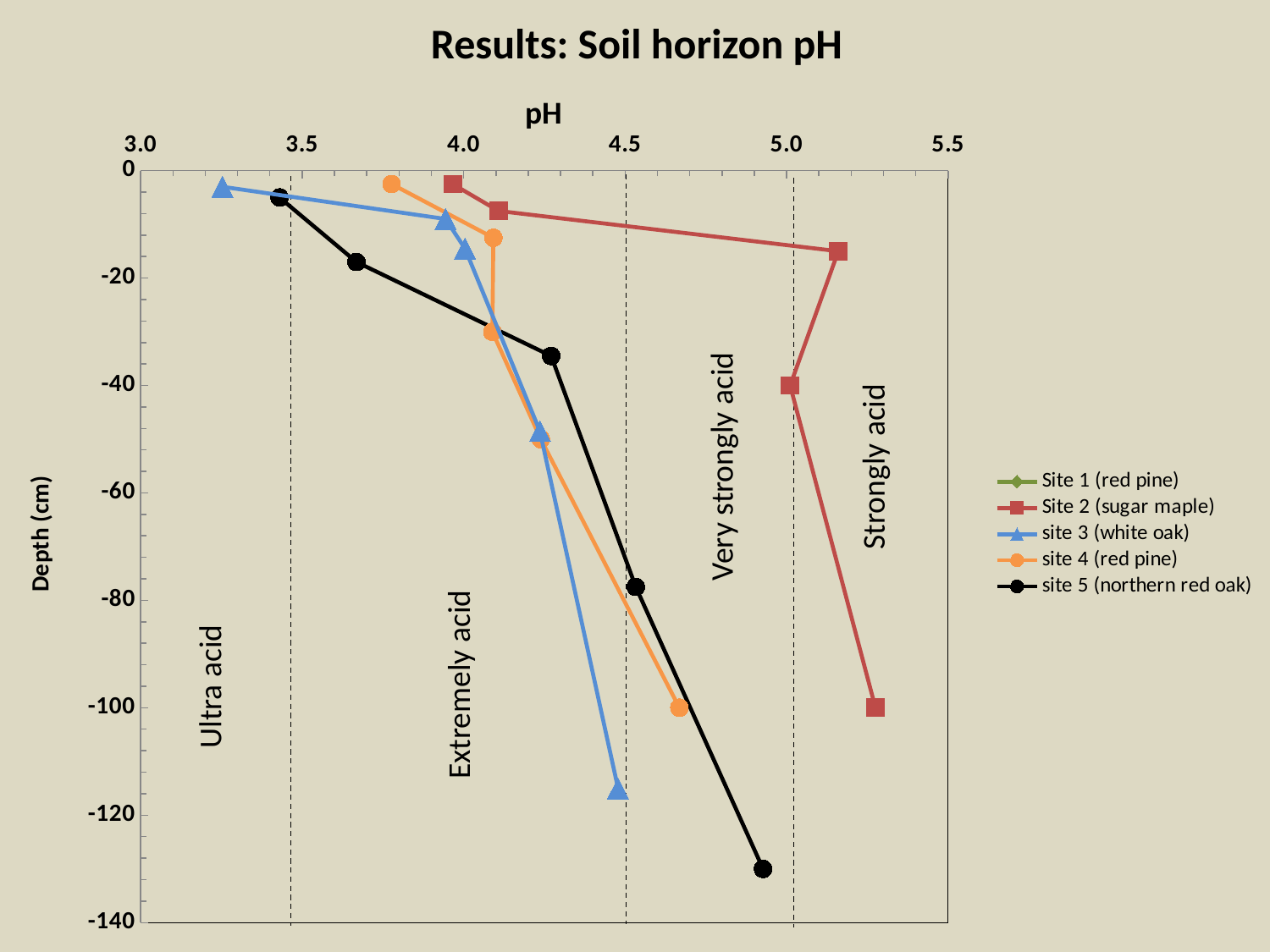
For site 5 (northern red oak), does pH increase or decrease as depth increases? increase What is the title of the chart? Results: Soil horizon pH What is the label of the vertical axis? Depth (cm) Is the pH of the shallowest point for site 3 (white oak) greater or less than 3.5? less Which series has the lowest pH at its shallowest point? site 3 (white oak) How many series does the legend list? 5 What kind of chart is shown on the slide? line chart Is the pH of the deepest point for Site 2 (sugar maple) greater or less than 5.0? greater Which series reaches the highest pH values on the chart? Site 2 (sugar maple) Which series extends to the greatest depth on the chart? site 5 (northern red oak) Is the pH of the deepest point for site 5 (northern red oak) greater or less than 4.5? greater How many data points are plotted for Site 2 (sugar maple)? 5